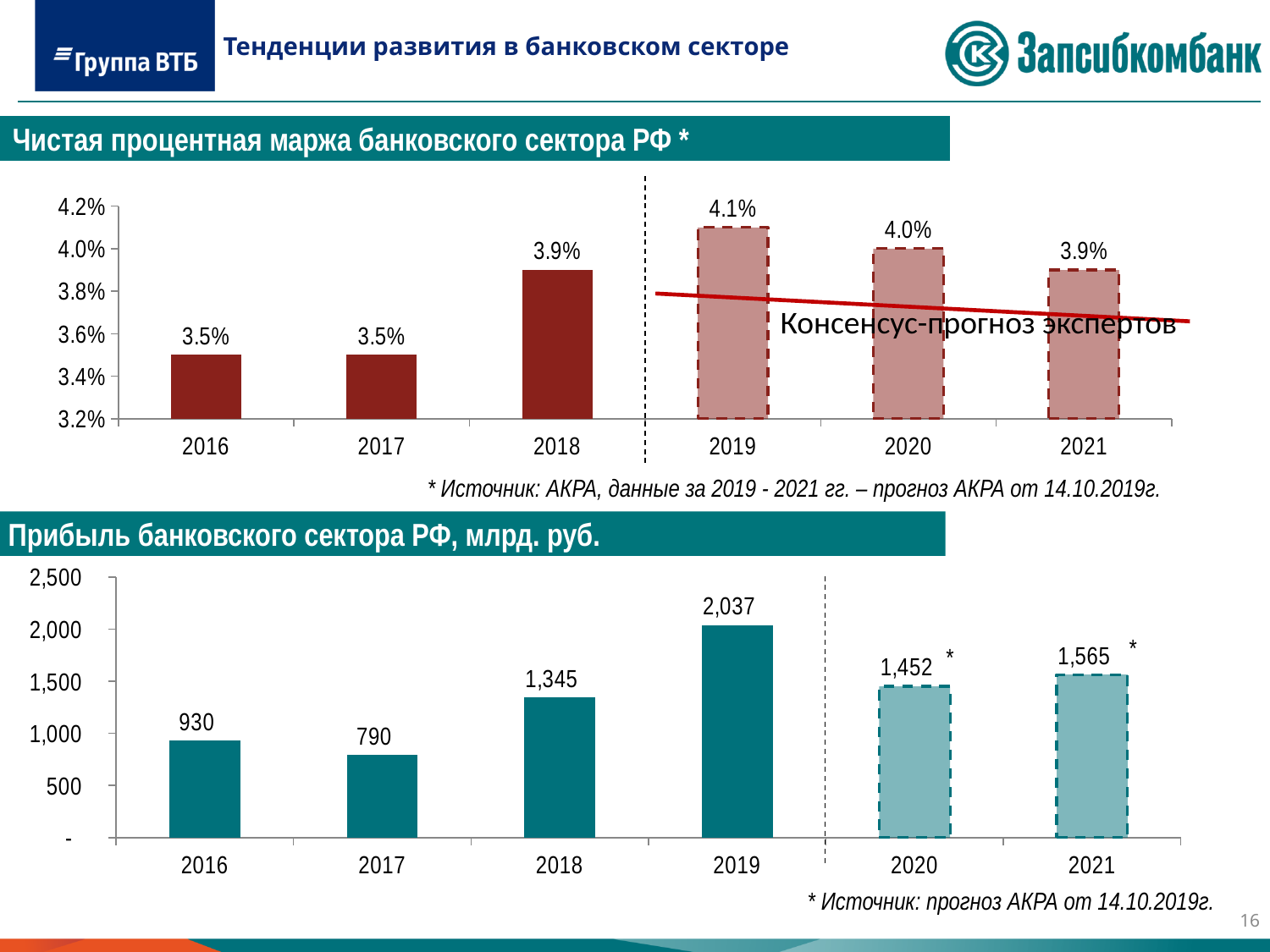
In the chart 'Прибыль банковского сектора РФ, млрд. руб.', what is the value for 2019? 2,037 In the chart 'Прибыль банковского сектора РФ, млрд. руб.', is the value for 2016 greater or less than 1,000? less What kind of chart is 'Прибыль банковского сектора РФ, млрд. руб.'? bar chart In the chart 'Чистая процентная маржа банковского сектора РФ', how many years are plotted? 6 In the chart 'Чистая процентная маржа банковского сектора РФ', do the values rise or fall from 2019 to 2021? fall In the chart 'Прибыль банковского сектора РФ, млрд. руб.', which is larger, the value for 2020 or the value for 2021? 2021 In the chart 'Прибыль банковского сектора РФ, млрд. руб.', what is the difference between the 2019 value and the 2018 value? 692 In the chart 'Чистая процентная маржа банковского сектора РФ', what is the value for 2018? 3.9% In the chart 'Чистая процентная маржа банковского сектора РФ', which year has the highest value? 2019 In the chart 'Чистая процентная маржа банковского сектора РФ', what is the difference between the 2019 value and the 2016 value? 0.6% In the chart 'Чистая процентная маржа банковского сектора РФ', what label is written on the red line over the forecast bars? Консенсус-прогноз экспертов In the chart 'Прибыль банковского сектора РФ, млрд. руб.', which year has the lowest value? 2017